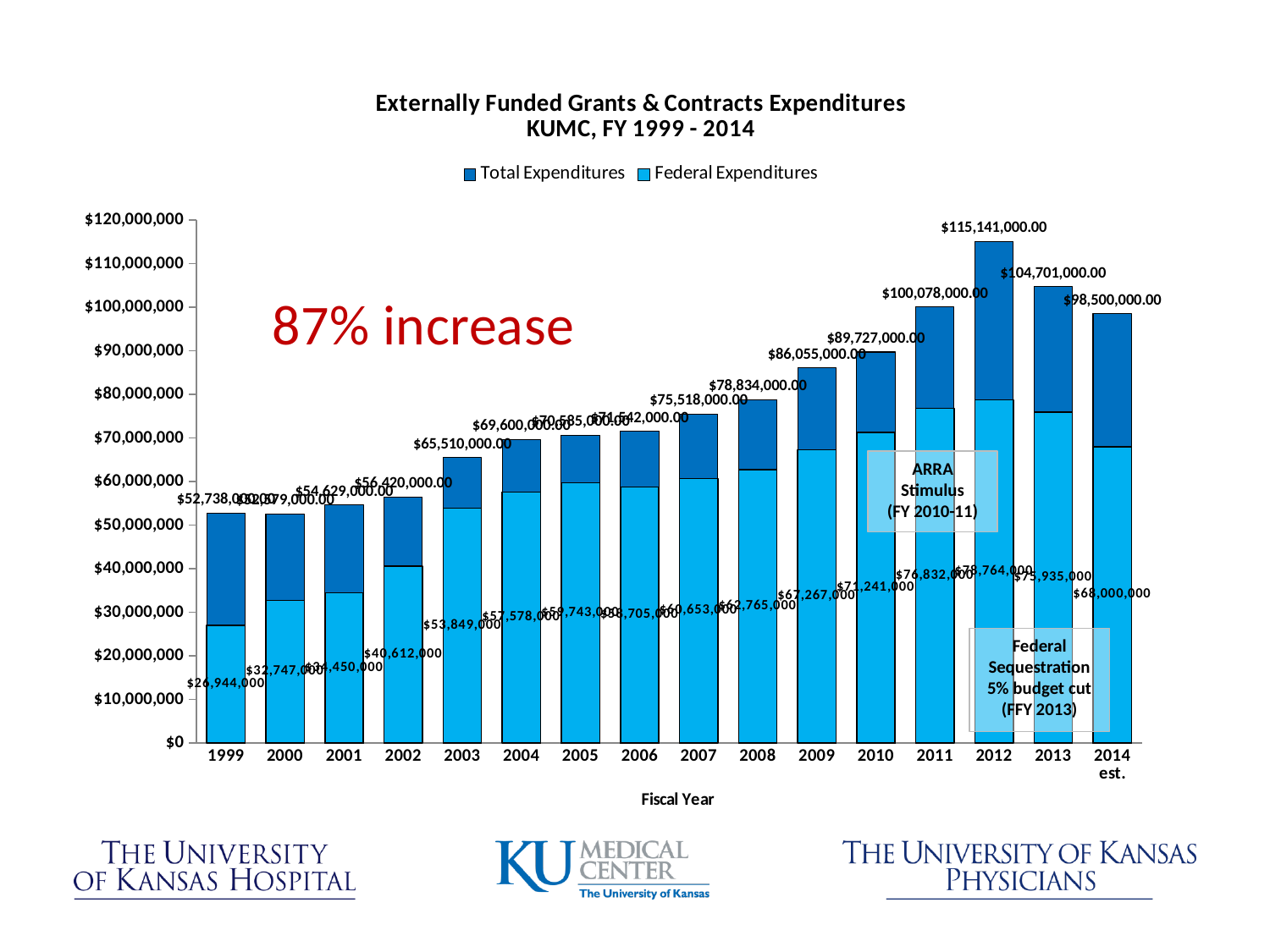
How many series does the legend list? 2 Is the Federal Expenditures value for 2002 greater or less than $50,000,000? less What kind of chart is shown on the slide? bar chart Do Total Expenditures rise or fall from 1999 to 2012? rise What is the value of Federal Expenditures for fiscal year 2014 est.? $68,000,000 Which fiscal year has higher Total Expenditures, 2010 or 2011? 2011 How many fiscal years are shown on the x axis? 16 What is the value of Federal Expenditures for fiscal year 1999? $26,944,000 Which fiscal year has the highest Total Expenditures? 2012 What is the difference between Total Expenditures in 2012 and in 2013? $10,440,000.00 What is the value of Total Expenditures for fiscal year 2009? $86,055,000.00 Which fiscal year has the lowest Federal Expenditures? 1999